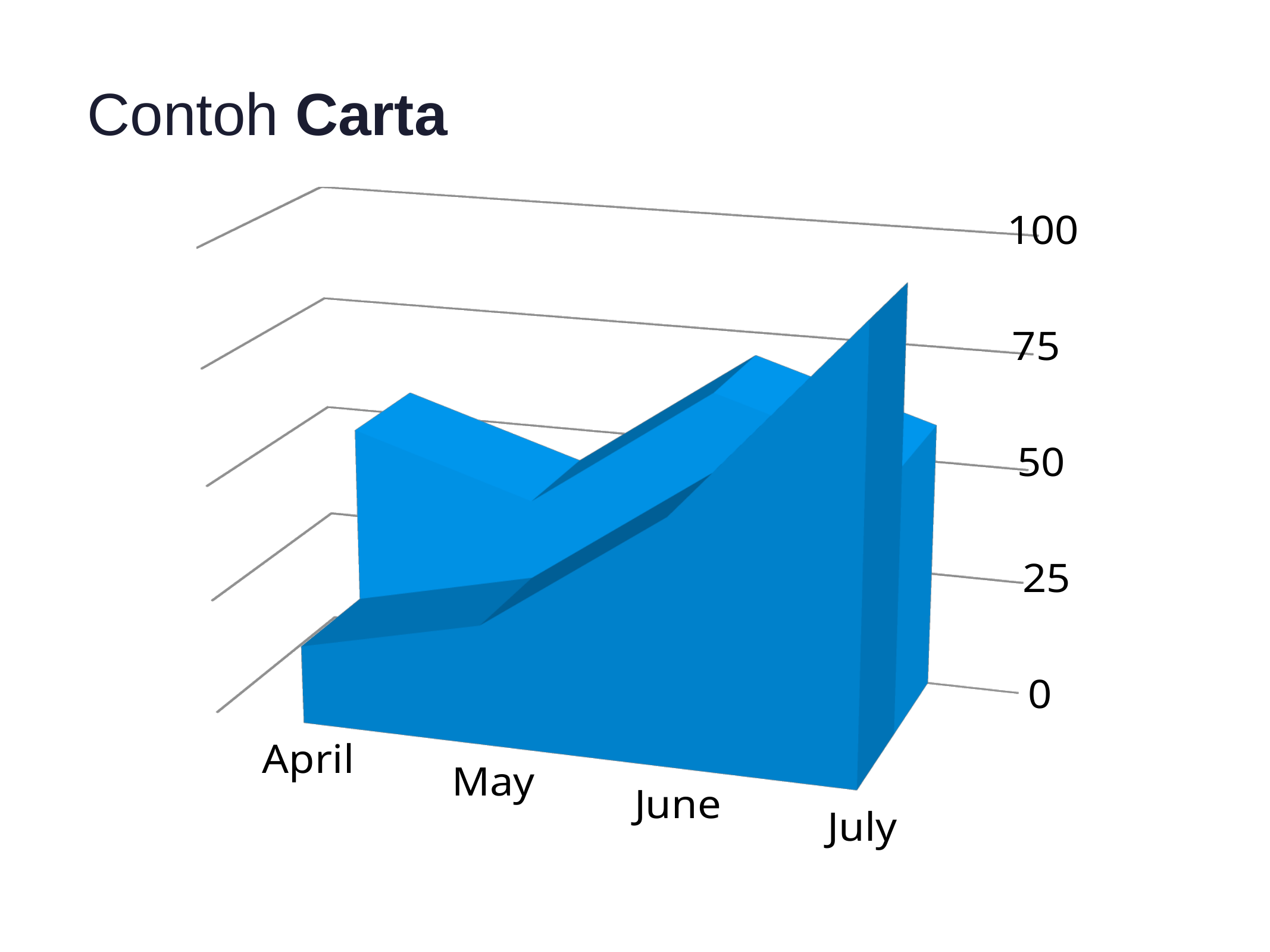
What is the title of the slide containing the chart? Contoh Carta Which category has the lowest value in the chart? April What kind of chart is shown on the slide? area chart Does the value rise or fall from May to July? rise How many categories are shown on the x axis of the chart? 4 Is the value for May greater or less than 75? less Which category has the highest value in the chart? July Which is larger, the value for July or the value for April? July Is the value for July greater or less than 50? greater Which is larger, the value for June or the value for May? June What is the highest value shown on the vertical axis of the chart? 100